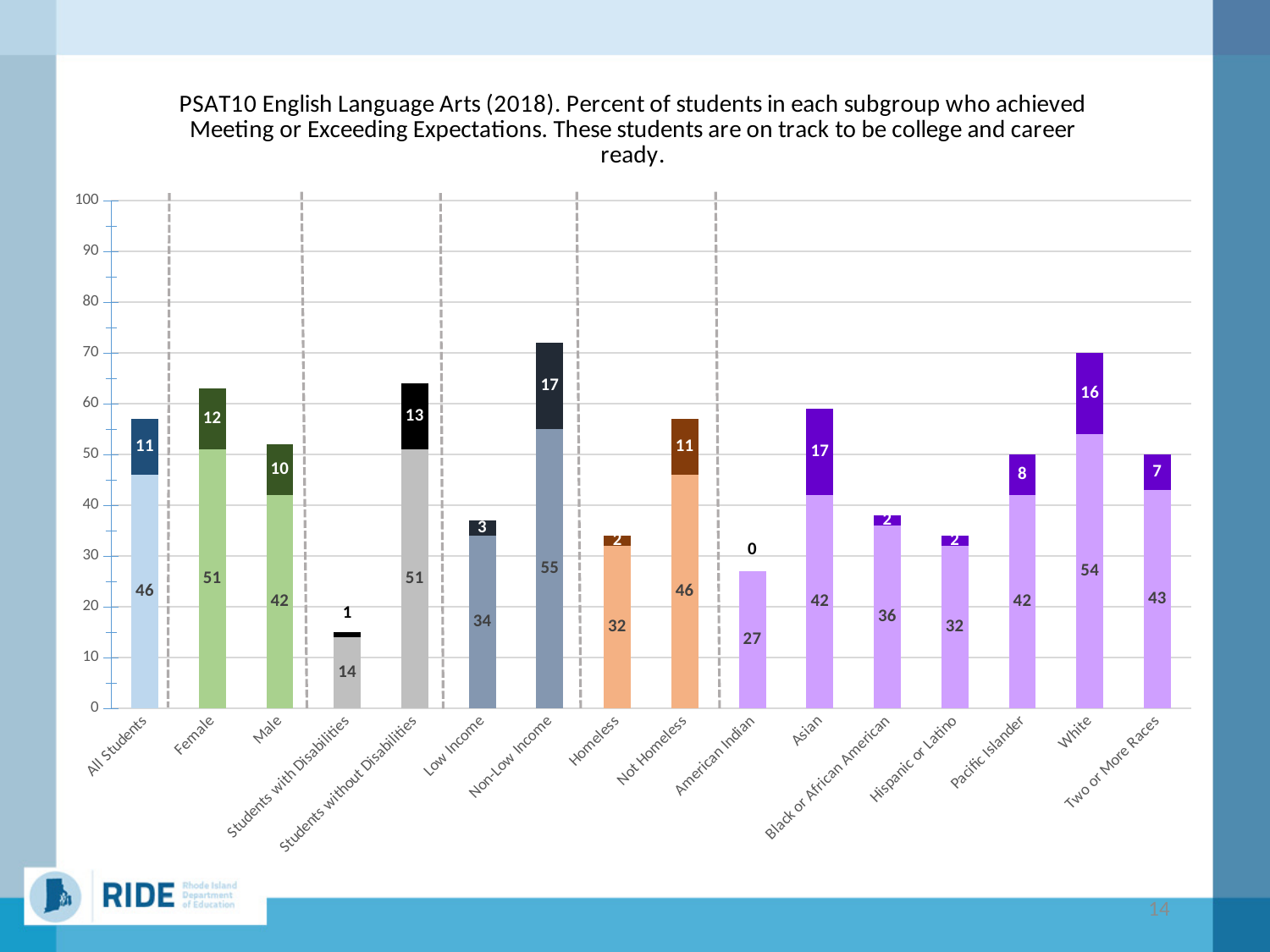
What is the value of the upper segment of the bar for American Indian? 0 How many subgroups (categories) are shown on the x axis? 16 What is the total height of the stacked bar for White? 70 What type of chart is shown on the slide? stacked bar chart Which subgroup has the shortest stacked bar overall? Students with Disabilities What is the value of the upper (top) segment of the bar for Non-Low Income? 17 Which has a larger lower segment value, Asian or Black or African American? Asian What is the total height of the stacked bar for Female? 63 What is the difference between the lower segment values for Female and Male? 9 Which subgroup has the tallest stacked bar overall? Non-Low Income What is the value of the lower segment of the bar for Students with Disabilities? 14 What is the value of the lower (bottom) segment of the bar for All Students? 46